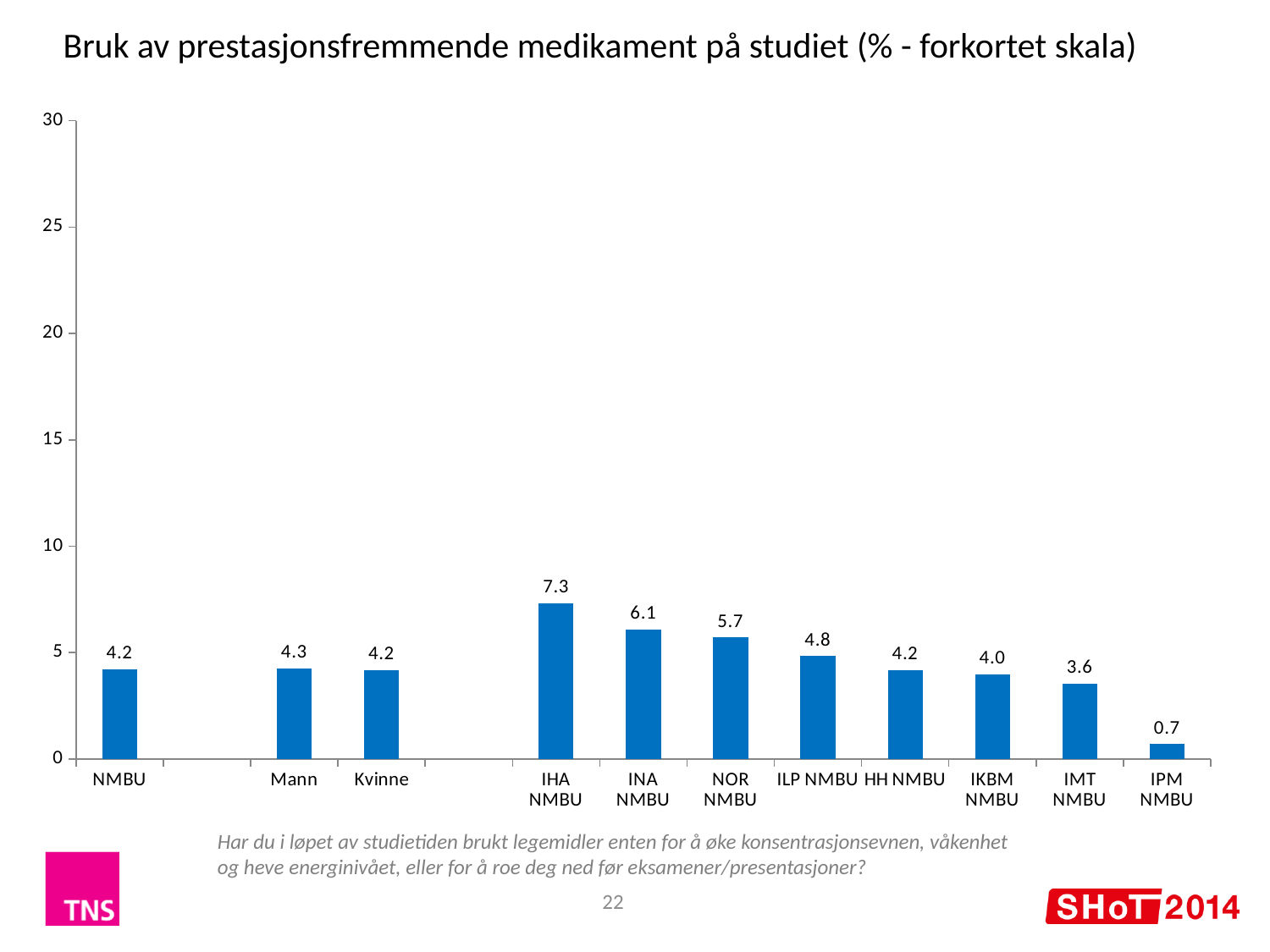
What is the value for Mann? 4.3 What is the difference between the values for IHA NMBU and INA NMBU? 1.2 What is the value for NOR NMBU? 5.7 What is the title of the chart? Bruk av prestasjonsfremmende medikament på studiet (% - forkortet skala) Which is larger, the value for ILP NMBU or the value for IKBM NMBU? ILP NMBU Is the value for INA NMBU greater or less than 5? greater Which category has the highest value? IHA NMBU What is the value for IHA NMBU? 7.3 What is the value for IPM NMBU? 0.7 How many bars are shown in the chart? 11 Which category has the lowest value? IPM NMBU What kind of chart is shown on the slide? Bar chart